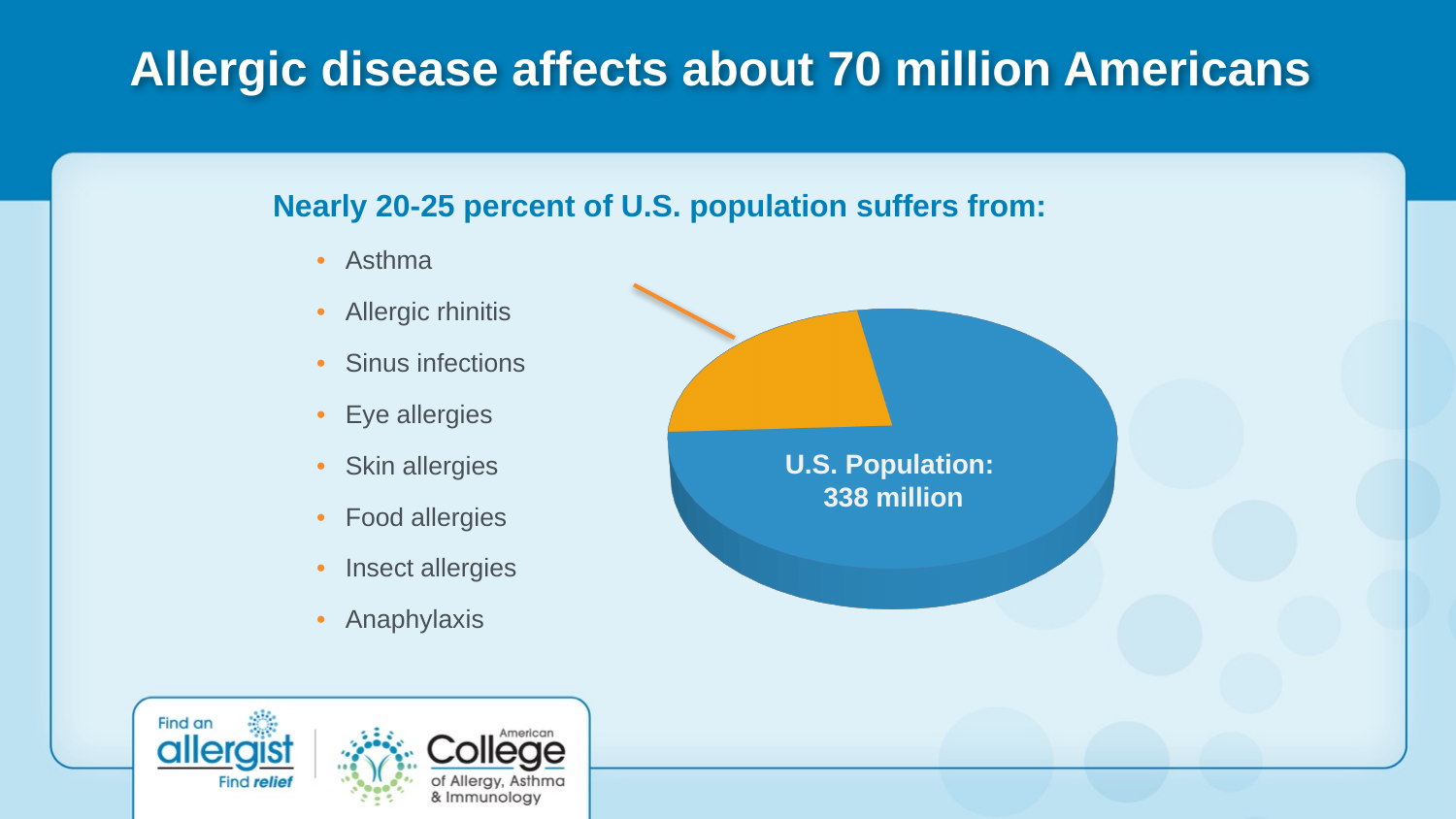
What label is printed on the large blue slice of the pie chart? U.S. Population: 338 million What kind of chart is shown on the slide? Pie chart How many slices does the pie chart have? 2 What population figure is printed on the pie chart? 338 million Which slice of the pie chart does the orange arrow point to? The orange slice What colour is the slice labelled "U.S. Population: 338 million"? Blue Which slice of the pie chart is larger, the blue one or the orange one? The blue one Which slice of the pie chart is the largest? The blue slice (U.S. Population: 338 million) Does the orange slice represent more or less than half of the pie? Less Which slice of the pie chart is the smallest? The orange slice